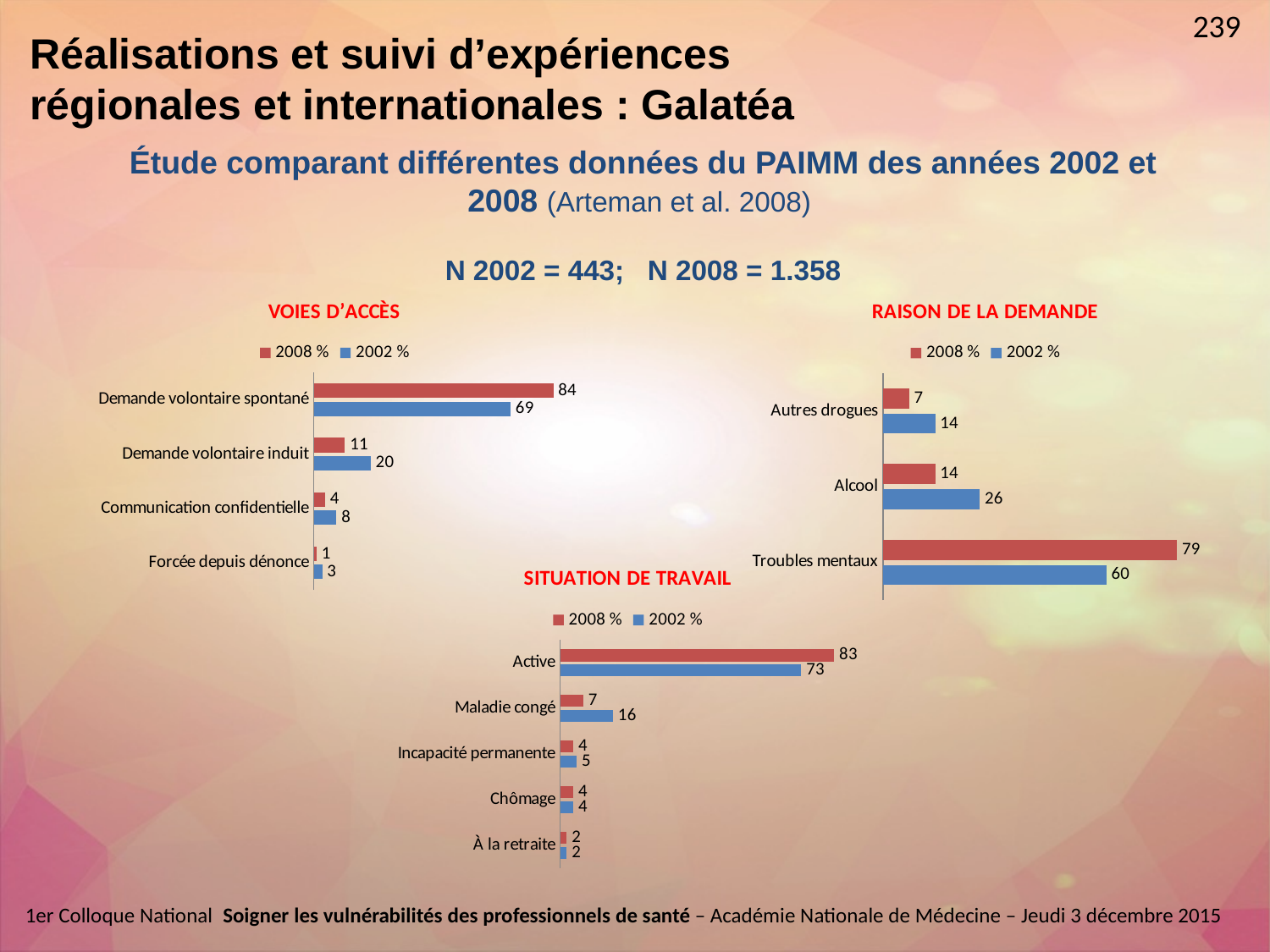
In the 'SITUATION DE TRAVAIL' chart, how many categories are shown? 5 In the 'RAISON DE LA DEMANDE' chart, what is the 2002 % value for 'Alcool'? 26 What type of chart is the 'SITUATION DE TRAVAIL' chart? bar chart In the 'VOIES D'ACCÈS' chart, what is the difference between the 2008 % and 2002 % values for 'Demande volontaire spontané'? 15 In the 'VOIES D'ACCÈS' chart, what is the 2002 % value for 'Demande volontaire induit'? 20 In the 'VOIES D'ACCÈS' chart, what is the 2008 % value for 'Demande volontaire spontané'? 84 In the 'RAISON DE LA DEMANDE' chart, is the 2008 % value for 'Autres drogues' larger or smaller than the 2002 % value? smaller In the 'SITUATION DE TRAVAIL' chart, how many series does the legend list? 2 In the 'SITUATION DE TRAVAIL' chart, what is the 2002 % value for 'Maladie congé'? 16 In the 'VOIES D'ACCÈS' chart, which category has the lowest 2008 % value? Forcée depuis dénonce In the 'RAISON DE LA DEMANDE' chart, which category has the highest 2008 % value? Troubles mentaux In the 'RAISON DE LA DEMANDE' chart, how many categories are shown? 3